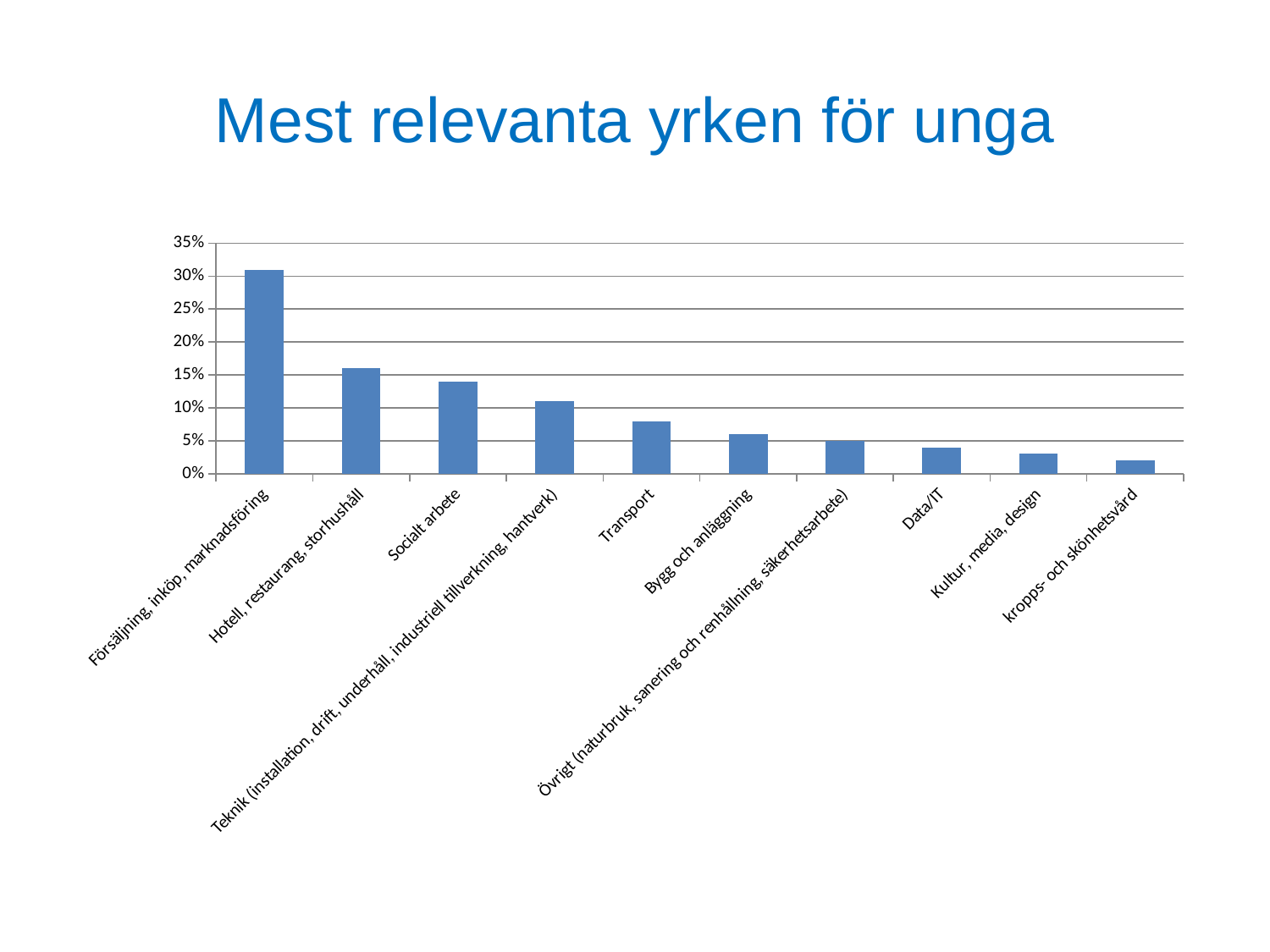
What kind of chart is shown on the slide? bar chart Is the value for Transport greater or less than 10%? less Is the value for Socialt arbete greater or less than 10%? greater Is the value for Kultur, media, design greater or less than 5%? less Which category has the highest value in the chart? Försäljning, inköp, marknadsföring What is the title of the slide? Mest relevanta yrken för unga Do the values rise or fall from left to right along the x axis? fall Which is larger, the value for Bygg och anläggning or the value for Data/IT? Bygg och anläggning Which category has the lowest value in the chart? kropps- och skönhetsvård How many occupation categories are plotted in the chart? 10